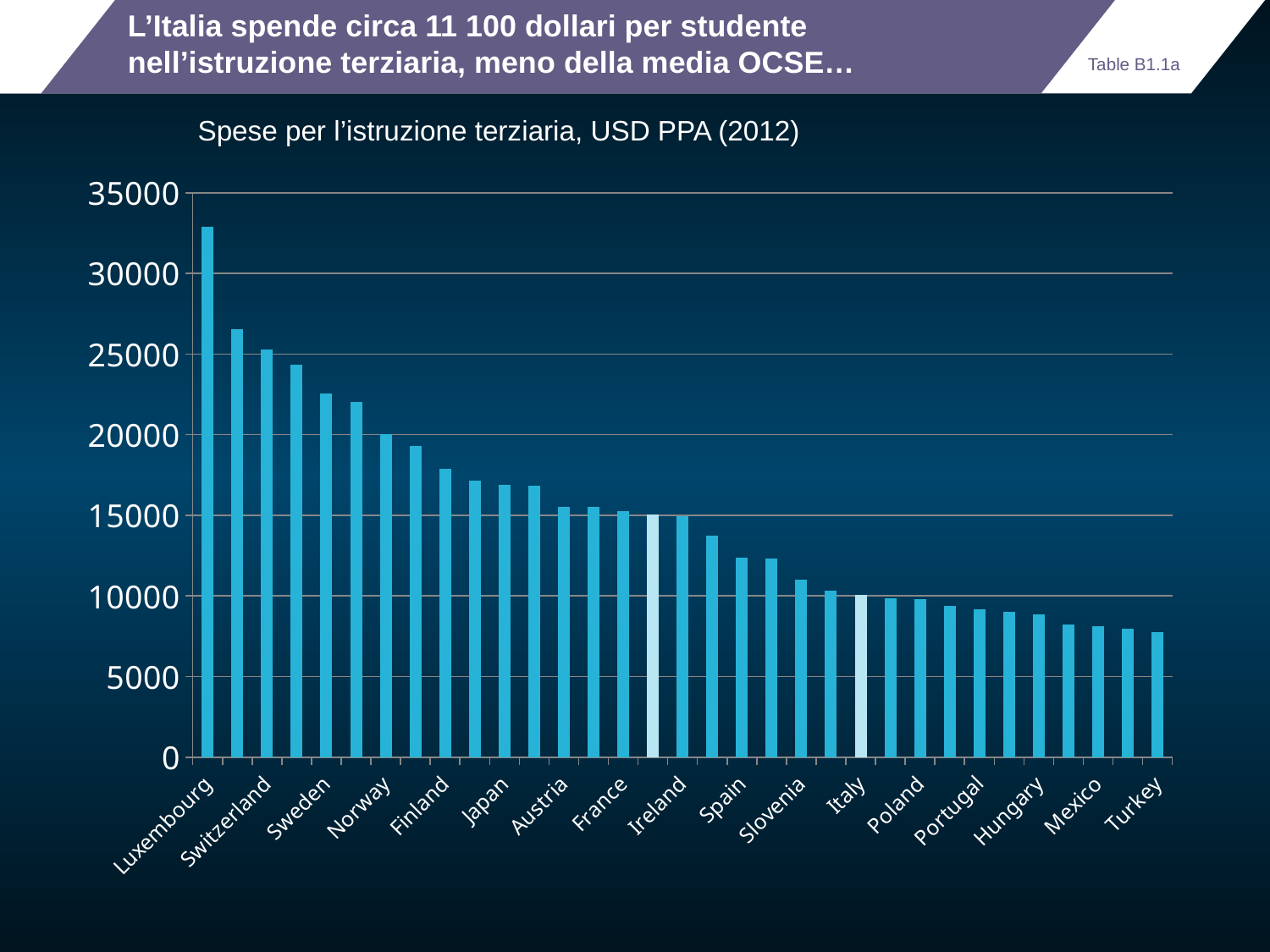
Is the value for Luxembourg greater or less than 30000? greater Which country has the highest expenditure per student in tertiary education? Luxembourg What is the title of the chart? Spese per l'istruzione terziaria, USD PPA (2012) Is the value for Italy greater or less than 15000? less Is the value for Turkey greater or less than 10000? less Do the values rise or fall from left to right along the x axis? fall Which labelled country's bar is drawn in a lighter colour than the others? Italy Which has a higher value, Spain or Italy? Spain Which has a higher value, Switzerland or Sweden? Switzerland What kind of chart is shown on the slide? bar chart Which labelled country has the lowest expenditure per student in tertiary education? Turkey